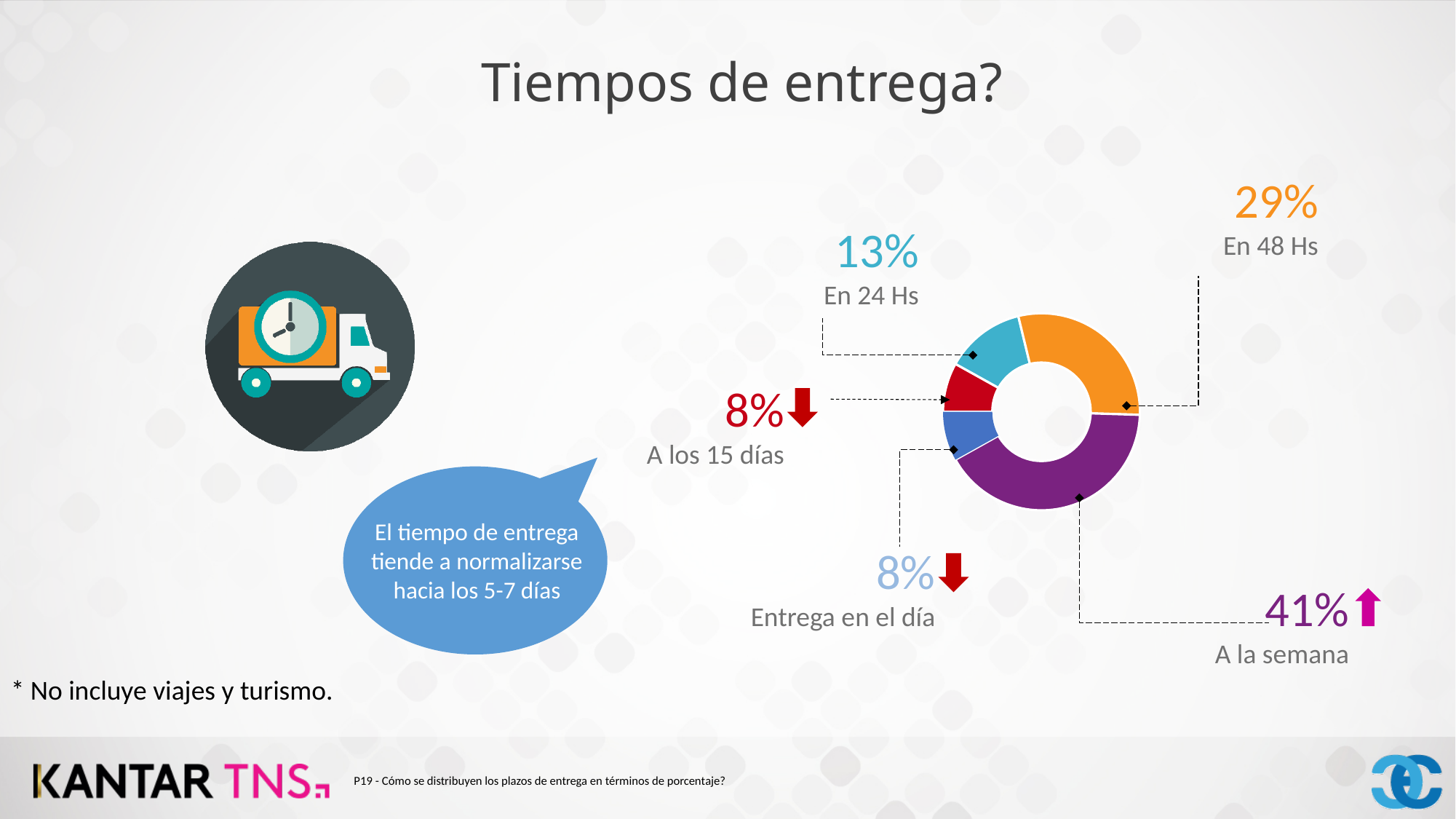
What percentage of deliveries are made 'En 48 Hs'? 29% Which delivery time category has the largest share? A la semana What kind of chart is shown on the slide? Doughnut chart What is the difference between the share for 'A la semana' and the share for 'En 48 Hs'? 12 percentage points How many categories are shown in the chart? 5 Which is larger, the share for 'En 24 Hs' or the share for 'En 48 Hs'? En 48 Hs What percentage of deliveries are made 'En 24 Hs'? 13% What percentage of deliveries are made 'A los 15 días'? 8% What percentage of deliveries are made 'A la semana'? 41% What is the title of the slide? Tiempos de entrega? What percentage corresponds to 'Entrega en el día'? 8% What colour is the segment for 'A la semana'? Purple